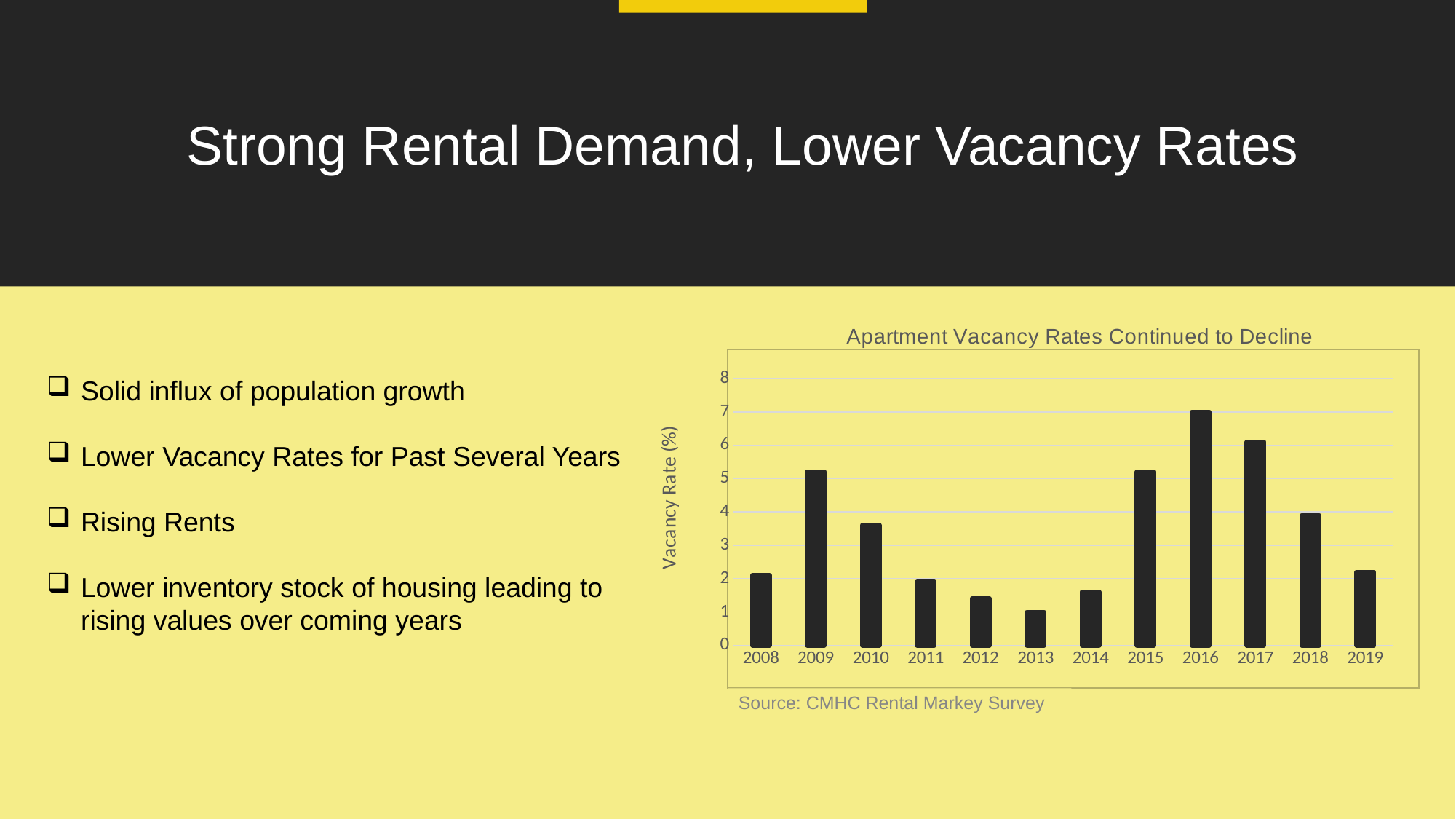
Which year has the lowest vacancy rate in the chart? 2013 Which year has the highest vacancy rate in the chart? 2016 Is the vacancy rate for 2016 greater or less than 6? greater What is the title of the chart? Apartment Vacancy Rates Continued to Decline Do the vacancy rates rise or fall from 2013 to 2016? rise What type of chart is shown on the slide? Bar chart Is the vacancy rate for 2009 greater or less than 4? greater How many years are shown on the x axis of the chart? 12 Is the vacancy rate for 2013 greater or less than 2? less Which year has a higher vacancy rate, 2017 or 2018? 2017 What is the label on the vertical axis of the chart? Vacancy Rate (%)